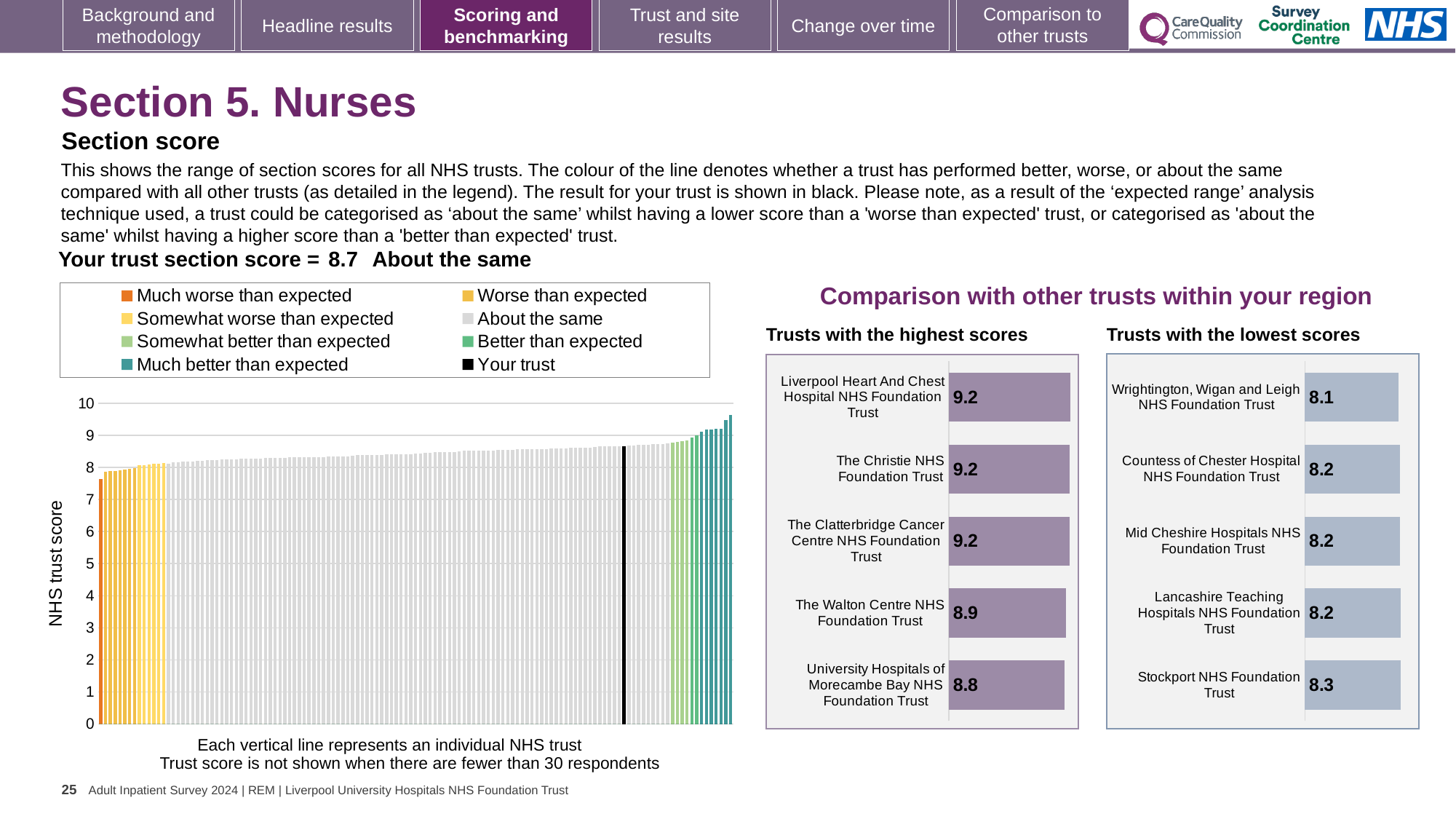
In the main chart on the left showing all NHS trusts, how many entries does the legend list? 8 In the 'Trusts with the highest scores' chart, what is the score for University Hospitals of Morecambe Bay NHS Foundation Trust? 8.8 In the 'Trusts with the lowest scores' chart, what is the score for Stockport NHS Foundation Trust? 8.3 In the 'Trusts with the highest scores' chart, what is the difference between the scores of The Walton Centre NHS Foundation Trust and University Hospitals of Morecambe Bay NHS Foundation Trust? 0.1 In the 'Trusts with the lowest scores' chart, which trust has the highest score? Stockport NHS Foundation Trust In the main chart on the left, do the trust scores rise or fall from left to right? Rise In the 'Trusts with the highest scores' chart, how many trusts are listed? 5 What kind of chart is the main chart on the left showing all NHS trusts? Bar chart In the 'Trusts with the lowest scores' chart, which trust has the lowest score? Wrightington, Wigan and Leigh NHS Foundation Trust In the 'Trusts with the highest scores' chart, what is the score for The Walton Centre NHS Foundation Trust? 8.9 In the 'Trusts with the lowest scores' chart, what is the score for Wrightington, Wigan and Leigh NHS Foundation Trust? 8.1 According to the slide, what is your trust's section score for Section 5. Nurses? 8.7